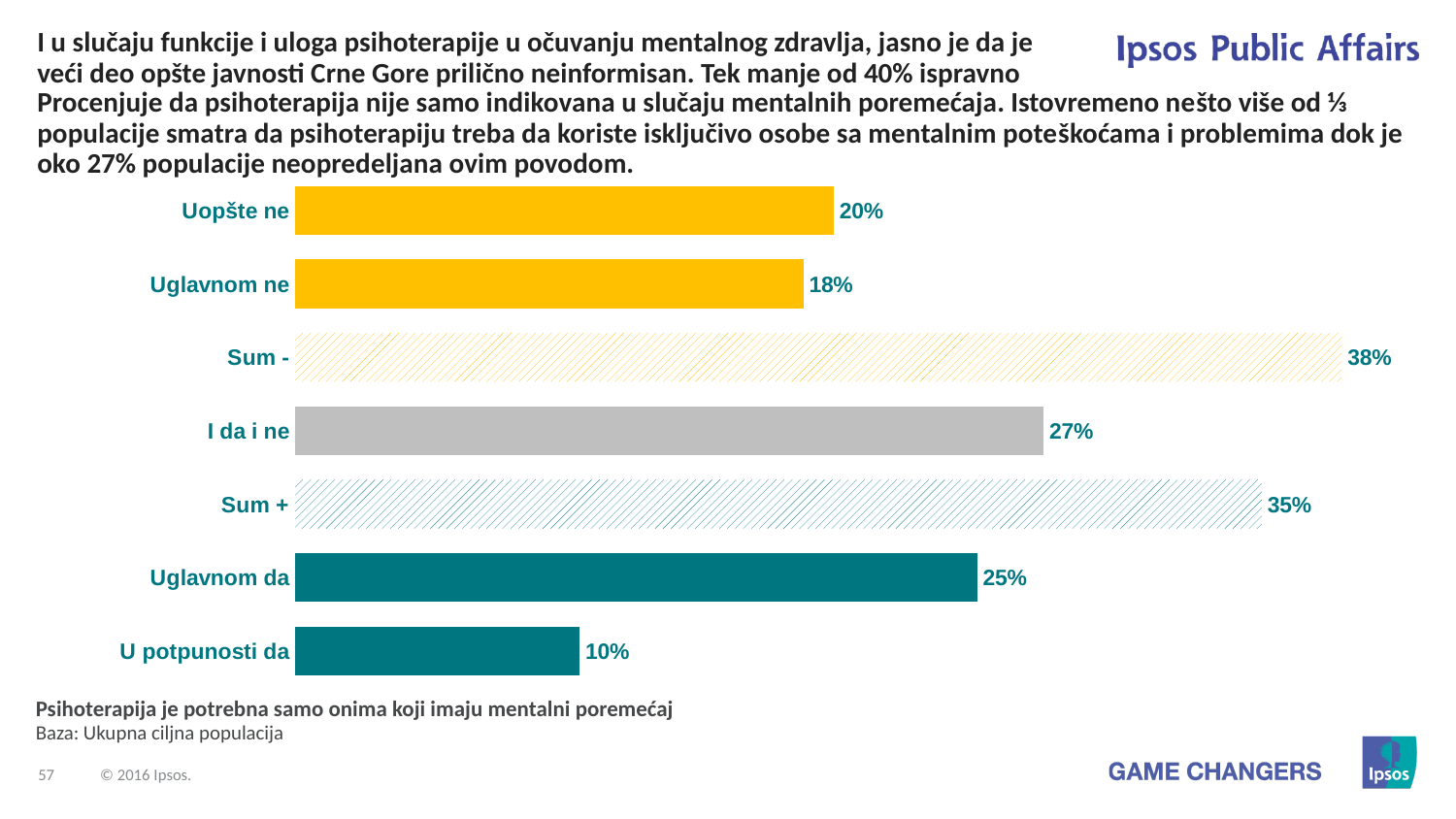
What is the value for "U potpunosti da"? 10% What is the value for "Uopšte ne"? 20% What kind of chart is shown on the slide? Bar chart What is the difference between "Uglavnom da" and "U potpunosti da"? 15% What is the value for "Uglavnom ne"? 18% How many bars are shown in the chart? 7 Which category has the highest value? Sum - Which category has the lowest value? U potpunosti da What is the value for "I da i ne"? 27% Which is larger, "Uopšte ne" or "Uglavnom ne"? Uopšte ne What is the difference between "Sum -" and "Sum +"? 3% What is the value for "Sum +"? 35%